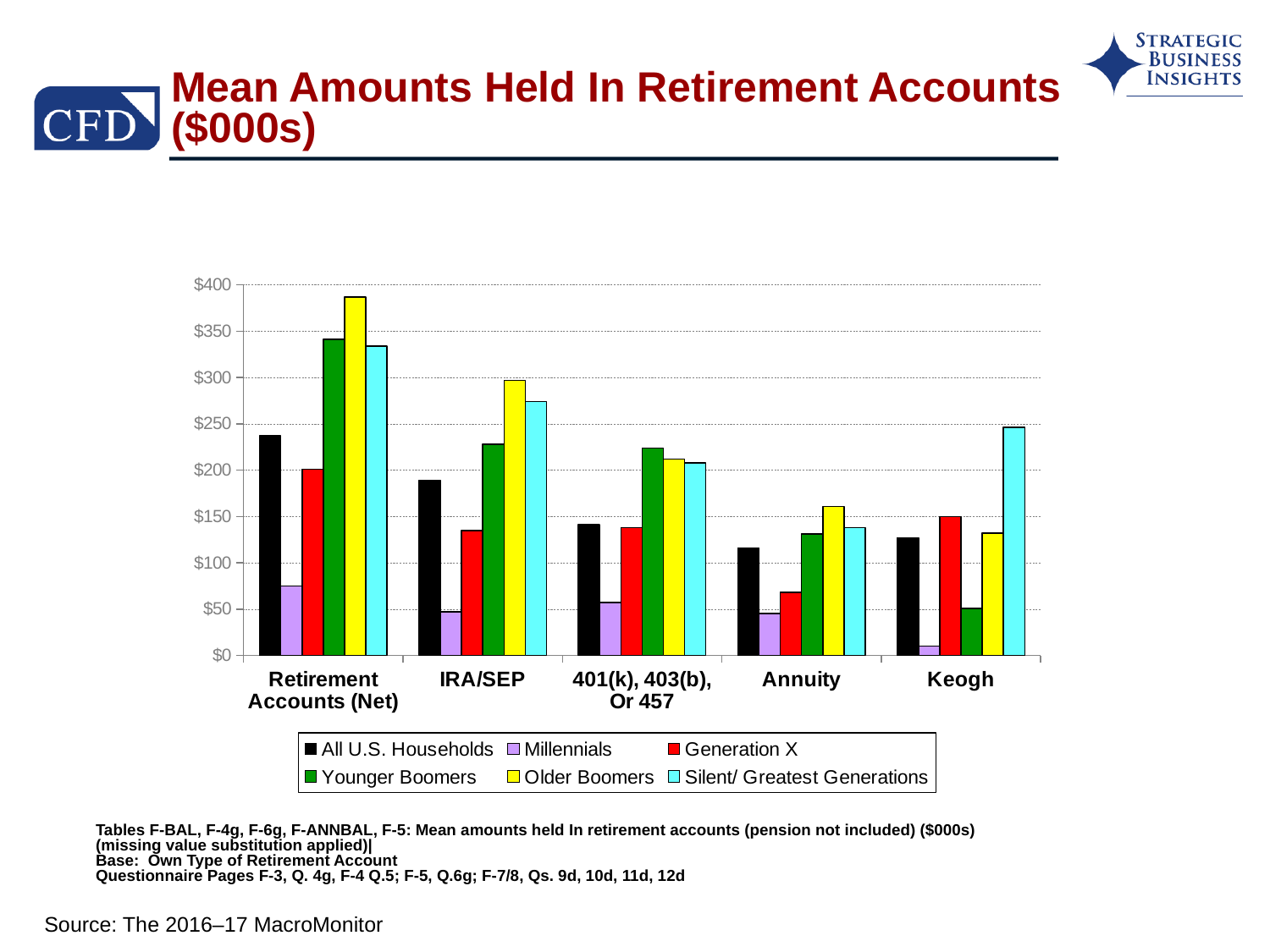
Is the value for Older Boomers in IRA/SEP greater or less than $250? greater What kind of chart is shown on the slide? Bar chart Is the value for Older Boomers in Retirement Accounts (Net) greater or less than $350? greater For Retirement Accounts (Net), which generation has the highest mean amount? Older Boomers For Keogh, which generation has the highest mean amount? Silent/ Greatest Generations How many series does the legend list? 6 For Annuity, which is larger: Older Boomers or Younger Boomers? Older Boomers How many account categories are shown along the x axis? 5 For Keogh, which is larger: Silent/ Greatest Generations or Generation X? Silent/ Greatest Generations Is the value for All U.S. Households in Annuity greater or less than $100? greater For Keogh, which generation has the lowest mean amount? Millennials